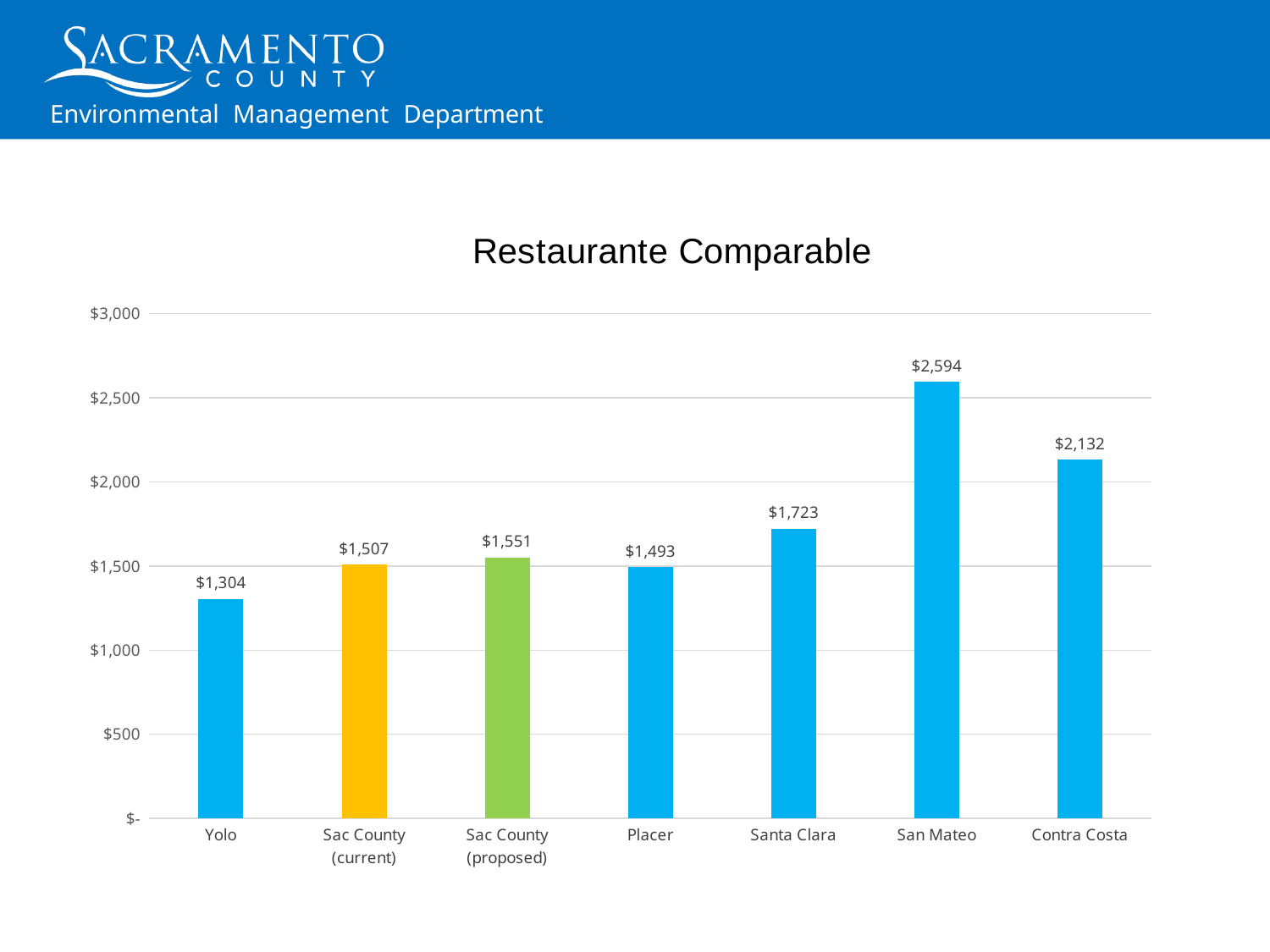
What is the value for Yolo? $1,304 Which category has the lowest value? Yolo What is the difference between the Sac County (proposed) and Sac County (current) values? $44 What kind of chart is shown on the slide? bar chart What is the value for Santa Clara? $1,723 What is the difference between the San Mateo and Contra Costa values? $462 What is the value for Sac County (proposed)? $1,551 Which category has the highest value? San Mateo Which is larger, the value for Contra Costa or the value for Santa Clara? Contra Costa How many categories are shown on the x axis? 7 Is the value for Placer greater or less than $2,000? less What is the title of the chart? Restaurante Comparable